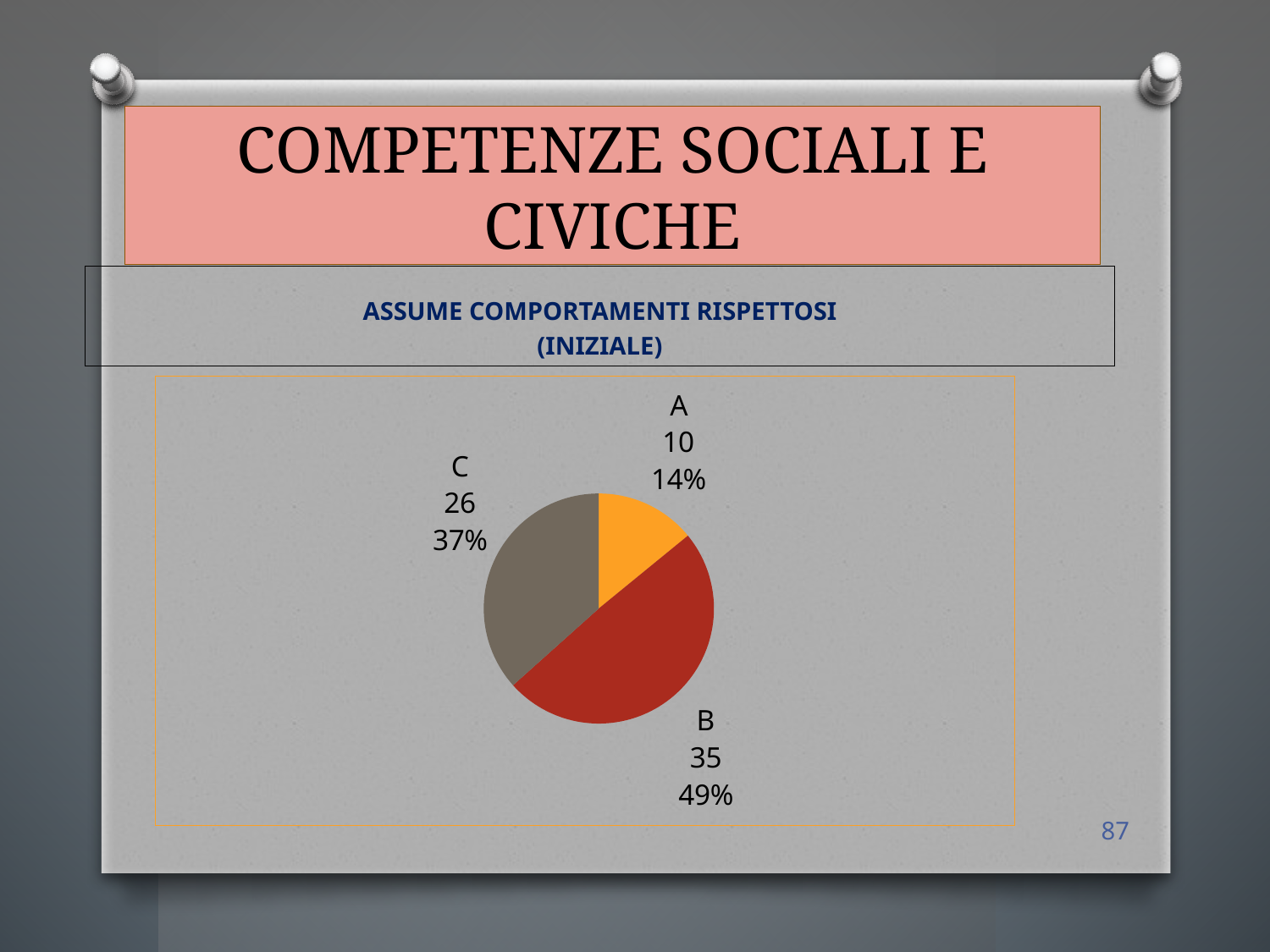
How many slices does the pie chart have? 3 What is the value for category A? 10 Which category has the largest slice? B Which category has the smallest slice? A Which is larger, the value for C or the value for A? C What percentage share does slice B have? 49% What kind of chart is shown on the slide? pie chart What is the value for category C? 26 What percentage share does slice A have? 14% What is the total of the three values in the pie chart? 71 What is the difference between the values for B and C? 9 What is the value for category B? 35